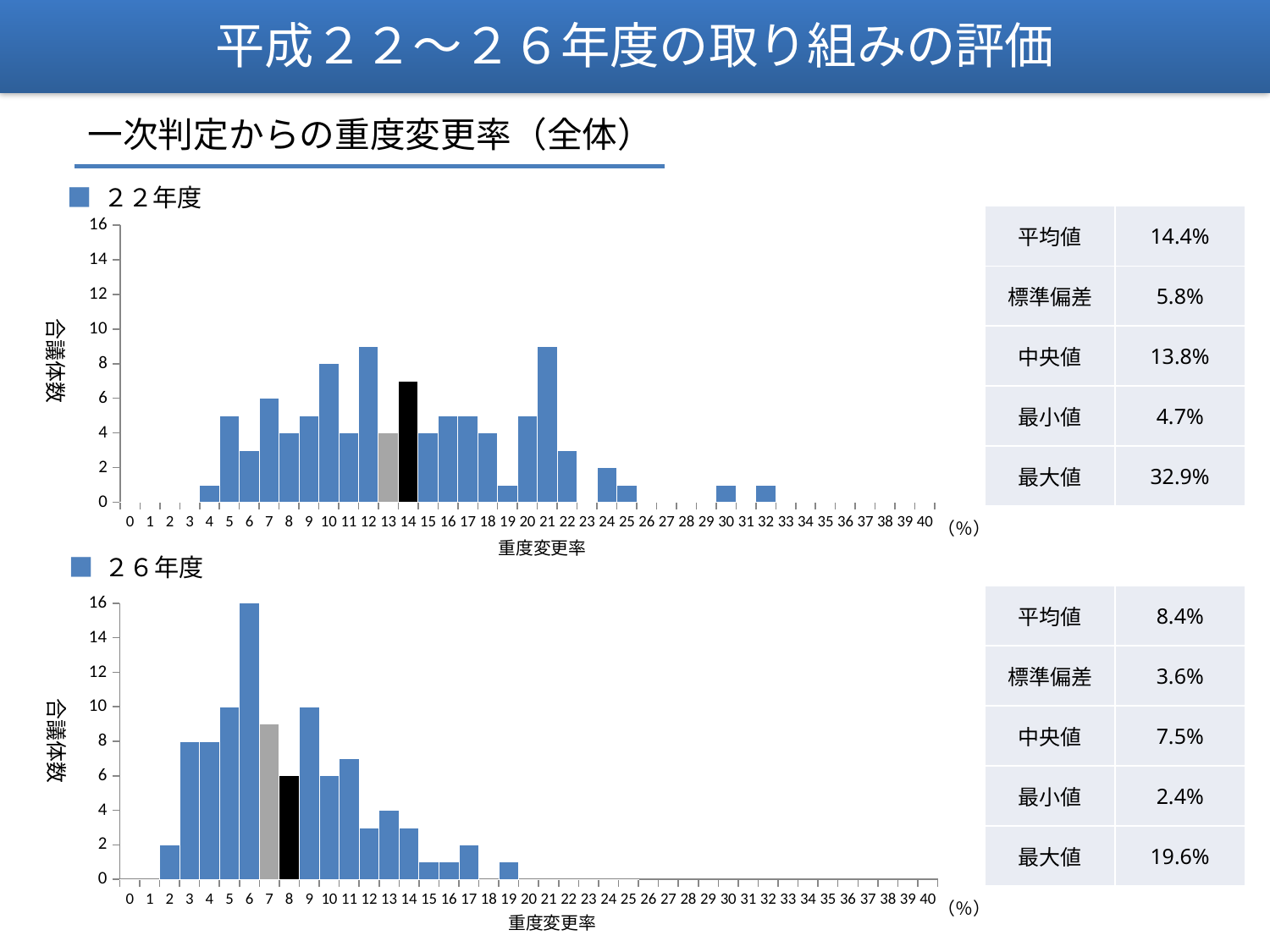
What kind of chart is used for the 22年度 data? bar chart In the 26年度 chart, is the 合議体数 at 重度変更率 11 greater or less than 6? greater In the 22年度 chart, which has a larger 合議体数: 重度変更率 10 or 重度変更率 7? 重度変更率 10 In the 26年度 chart, which 重度変更率 value has the highest 合議体数? 6 What is the label of the horizontal axis on the 26年度 chart? 重度変更率 In the 22年度 chart, what is the 合議体数 at 重度変更率 10? 8 In the 22年度 chart, is the 合議体数 at 重度変更率 12 greater or less than 8? greater In the 26年度 chart, what is the difference in 合議体数 between 重度変更率 6 and 重度変更率 5? 6 What is the label of the vertical axis on the 22年度 chart? 合議体数 In the 26年度 chart, which has a larger 合議体数: 重度変更率 5 or 重度変更率 3? 重度変更率 5 In the 26年度 chart, what is the 合議体数 at 重度変更率 6? 16 How many charts are shown on the slide? 2